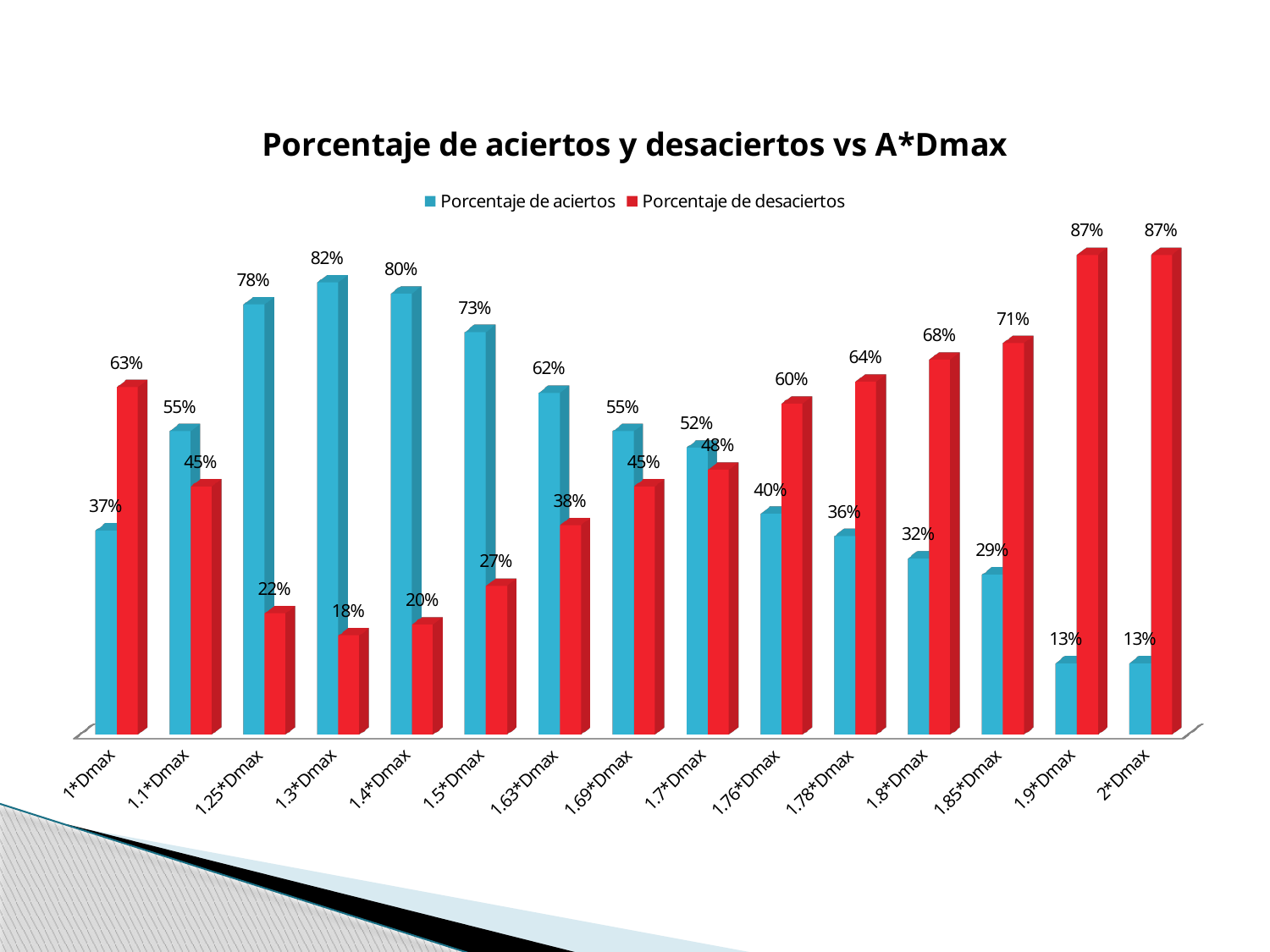
How many categories are shown on the x axis? 15 What is the title of the chart? Porcentaje de aciertos y desaciertos vs A*Dmax What is the Porcentaje de aciertos for 1.63*Dmax? 62% Which category has the highest Porcentaje de aciertos? 1.3*Dmax What kind of chart is shown on the slide? Bar chart How many series does the legend list? 2 What is the Porcentaje de desaciertos for 1.85*Dmax? 71% Which category has the lowest Porcentaje de desaciertos? 1.3*Dmax What is the difference between Porcentaje de desaciertos and Porcentaje de aciertos for 1*Dmax? 26% What is the Porcentaje de aciertos for 1.3*Dmax? 82% From 1.76*Dmax to 2*Dmax, does the Porcentaje de desaciertos rise or fall? Rise For 1.7*Dmax, which is larger: Porcentaje de aciertos or Porcentaje de desaciertos? Porcentaje de aciertos